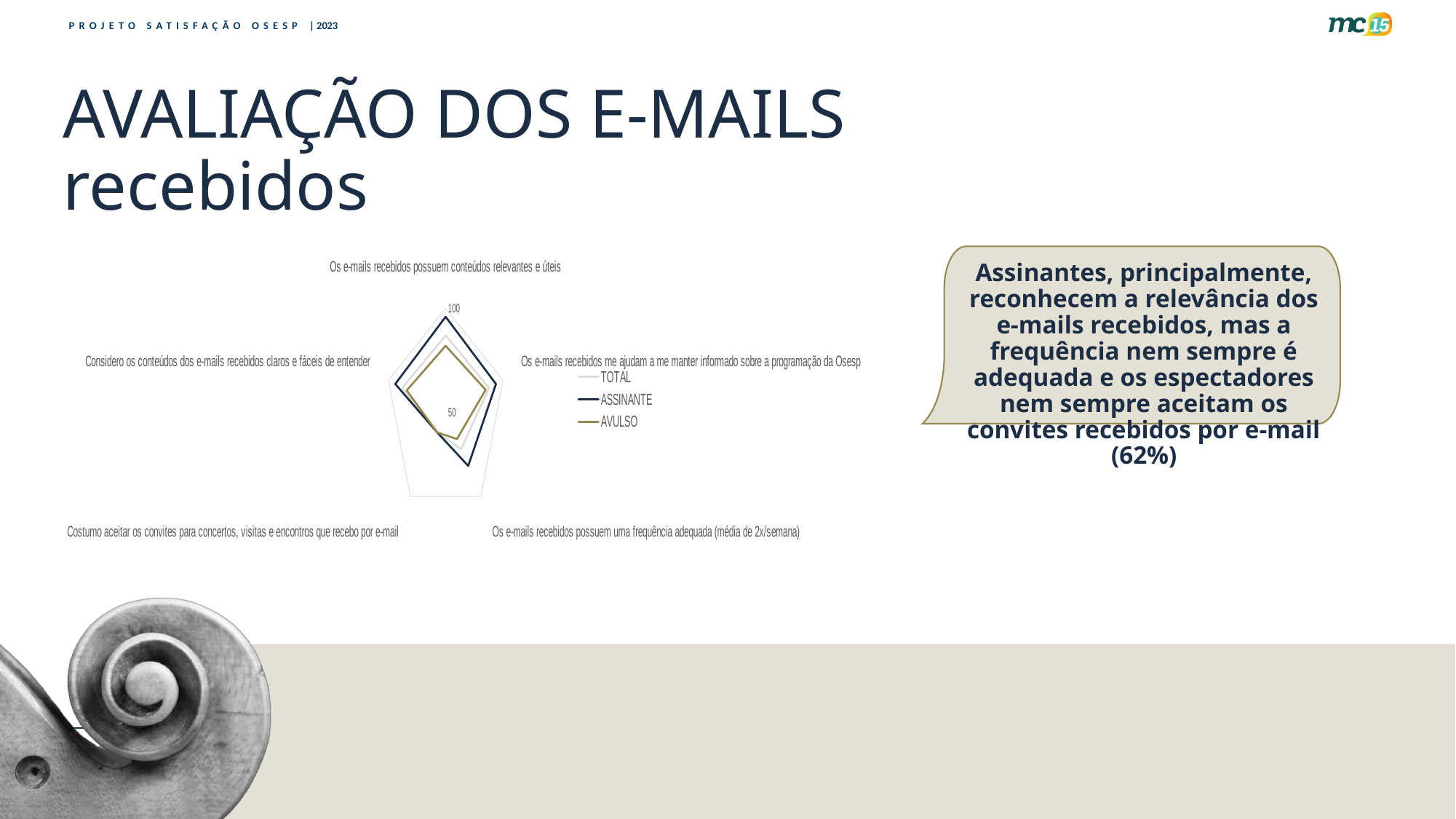
Which series are listed in the chart legend? TOTAL, ASSINANTE, AVULSO For 'Os e-mails recebidos possuem conteúdos relevantes e úteis', which series has the larger value, ASSINANTE or AVULSO? ASSINANTE Which series has the highest value for 'Os e-mails recebidos me ajudam a me manter informado sobre a programação da Osesp'? ASSINANTE For 'Considero os conteúdos dos e-mails recebidos claros e fáceis de entender', which series has the larger value, ASSINANTE or AVULSO? ASSINANTE Which series has the lowest value for 'Os e-mails recebidos possuem conteúdos relevantes e úteis'? AVULSO What kind of chart is shown on the slide? Radar chart How many categories (axes) does the radar chart have? 5 For 'Os e-mails recebidos possuem uma frequência adequada (média de 2x/semana)', which series has the larger value, ASSINANTE or AVULSO? ASSINANTE How many series does the chart legend list? 3 Is the ASSINANTE value for 'Os e-mails recebidos me ajudam a me manter informado sobre a programação da Osesp' greater or less than 50? greater Is the ASSINANTE value for 'Os e-mails recebidos possuem conteúdos relevantes e úteis' greater or less than 50? greater